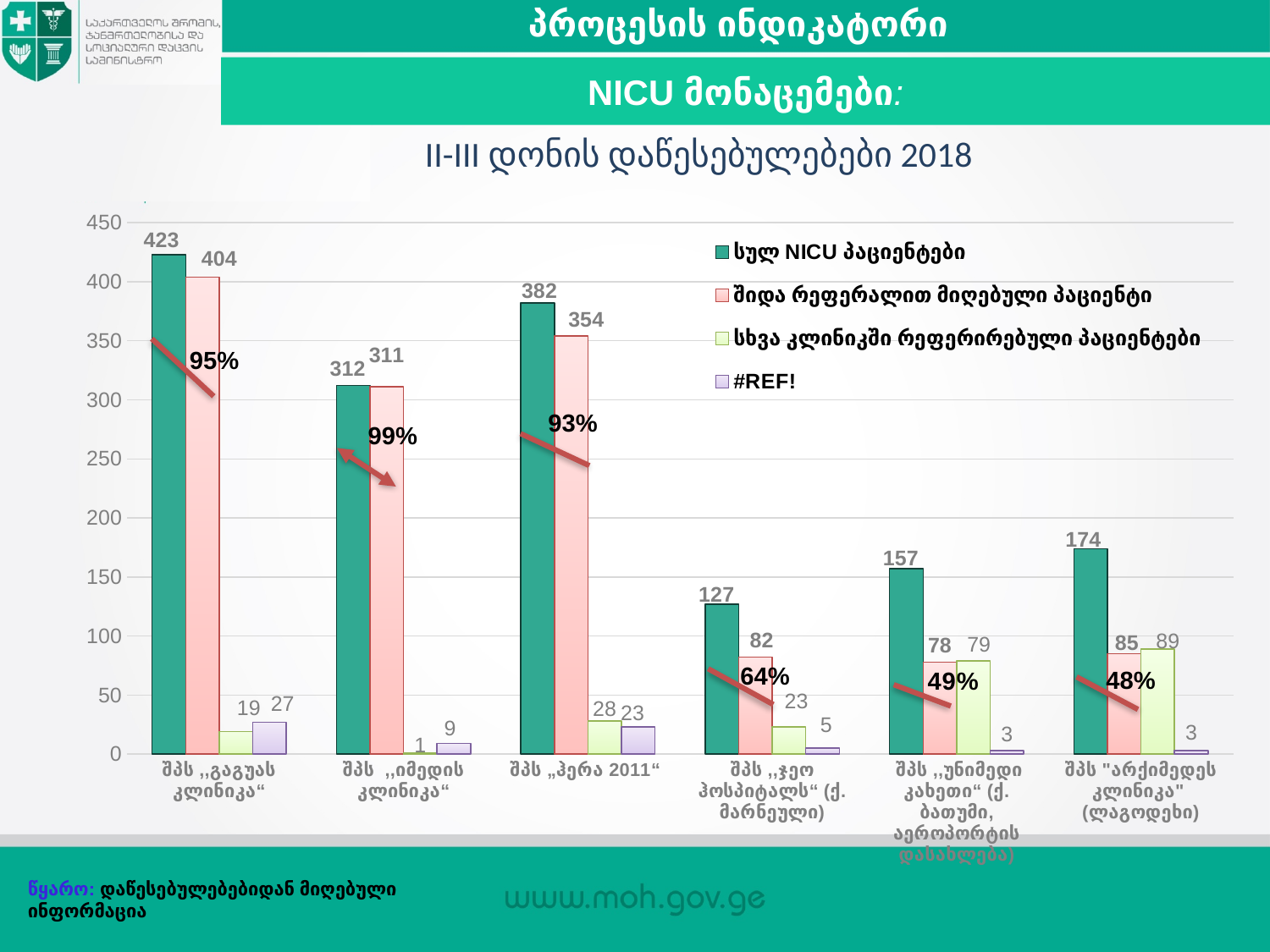
What is the value of სხვა კლინიკაში რეფერირებული პაციენტები for შპს „უნიმედი კახეთი"? 79 What is the value of შიდა რეფერალით მიღებული პაციენტი for შპს „ჰერა 2011"? 354 What type of chart is shown on the slide? bar chart What is the value of სულ NICU პაციენტები for შპს „გაგუას კლინიკა"? 423 What is the title of the chart? II-III დონის დაწესებულებები 2018 What is the difference between სულ NICU პაციენტები and შიდა რეფერალით მიღებული პაციენტი for შპს „იმედის კლინიკა"? 1 How many clinics (categories) are shown on the x axis? 6 What percentage label is shown above the bars for შპს „ჯეო ჰოსპიტალს" (ქ. მარნეული)? 64% Which clinic has the highest value for სულ NICU პაციენტები? შპს „გაგუას კლინიკა" Which is larger for შპს "არქიმედეს კლინიკა": შიდა რეფერალით მიღებული პაციენტი or სხვა კლინიკაში რეფერირებული პაციენტები? სხვა კლინიკაში რეფერირებული პაციენტები How many series does the legend list? 4 Which clinic has the lowest value for სულ NICU პაციენტები? შპს „ჯეო ჰოსპიტალს" (ქ. მარნეული)